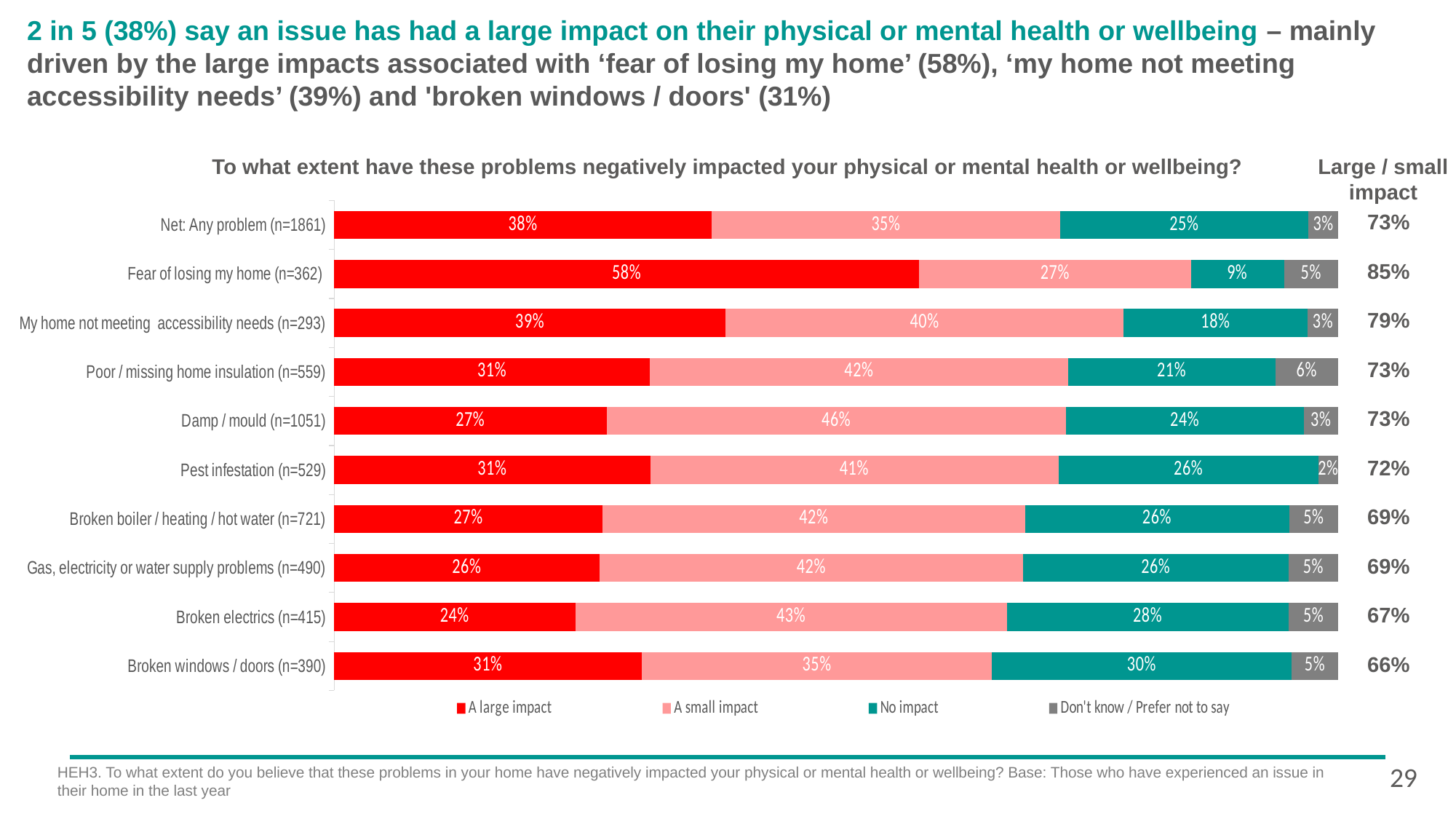
Which category has the highest 'A large impact' value? Fear of losing my home Which category has the lowest 'A large impact' value? Broken electrics What is the 'No impact' value for 'Broken windows / doors'? 30% What is the combined 'Large / small impact' value shown for 'My home not meeting accessibility needs'? 79% What kind of chart is shown on the slide? Stacked bar chart What is the difference between the 'A large impact' values for 'Fear of losing my home' and 'Net: Any problem'? 20% How many series does the legend list? 4 What colour represents 'No impact' in the chart? Teal What is the 'A small impact' value for 'Damp / mould'? 46% Which has a larger 'No impact' value: 'Broken electrics' or 'Damp / mould'? Broken electrics How many categories are shown on the chart? 10 What percentage of respondents with 'Fear of losing my home' reported a large impact? 58%